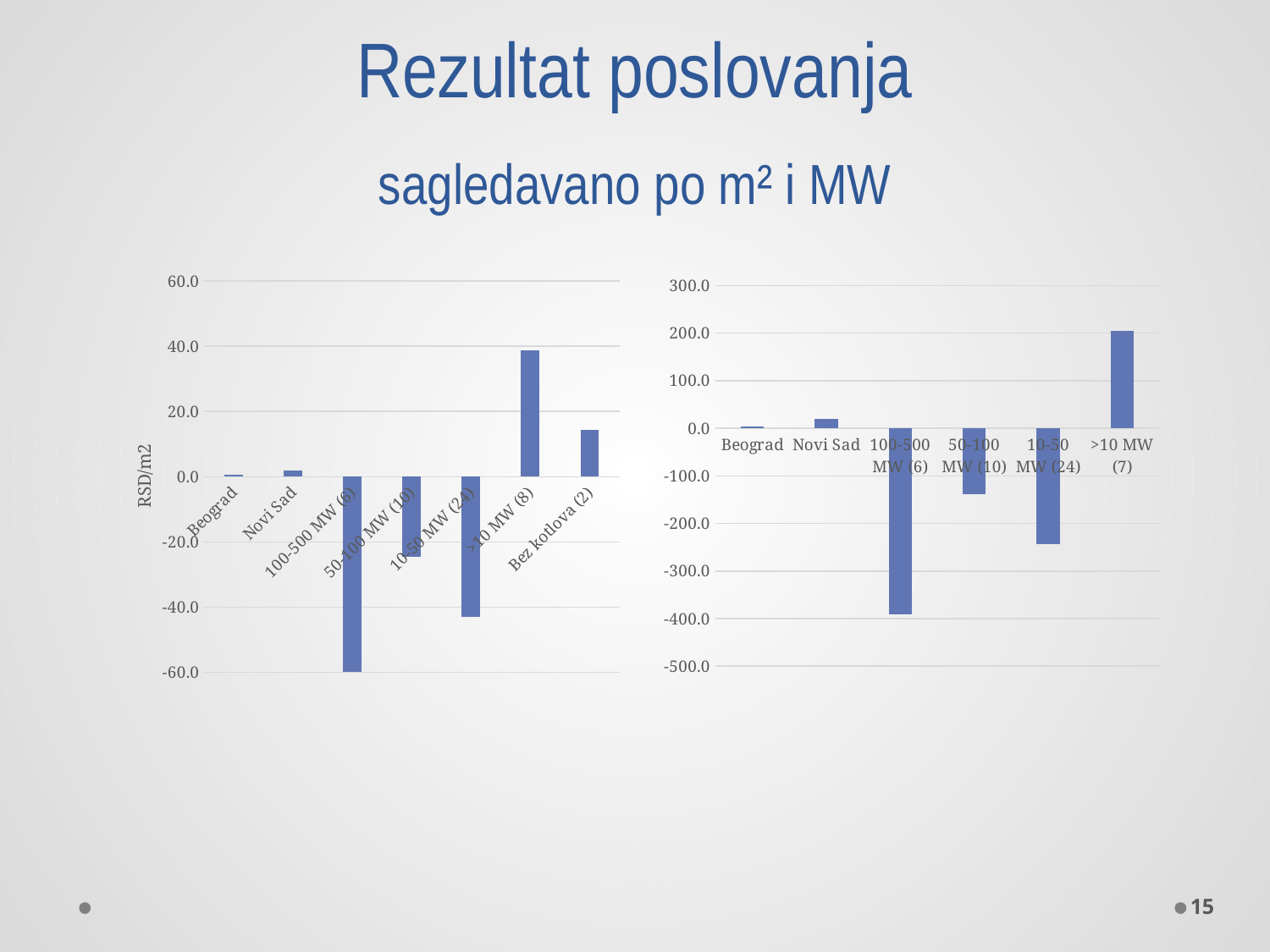
What kind of chart is the left chart on the slide? bar chart In the right chart, which category has the lowest value? 100-500 MW (6) In the right chart, which category has the highest value? >10 MW (7) In the left chart, which category has the highest value? >10 MW (8) What is the vertical axis title of the left chart? RSD/m2 How many categories does the right chart show? 6 In the right chart, is the value for 50-100 MW (10) greater or less than -200.0? greater In the right chart, which is larger, the value for Novi Sad or the value for Beograd? Novi Sad In the left chart, is the value for 10-50 MW (24) greater or less than -40.0? less How many categories does the left chart show? 7 In the left chart, which category has the lowest value? 100-500 MW (6)